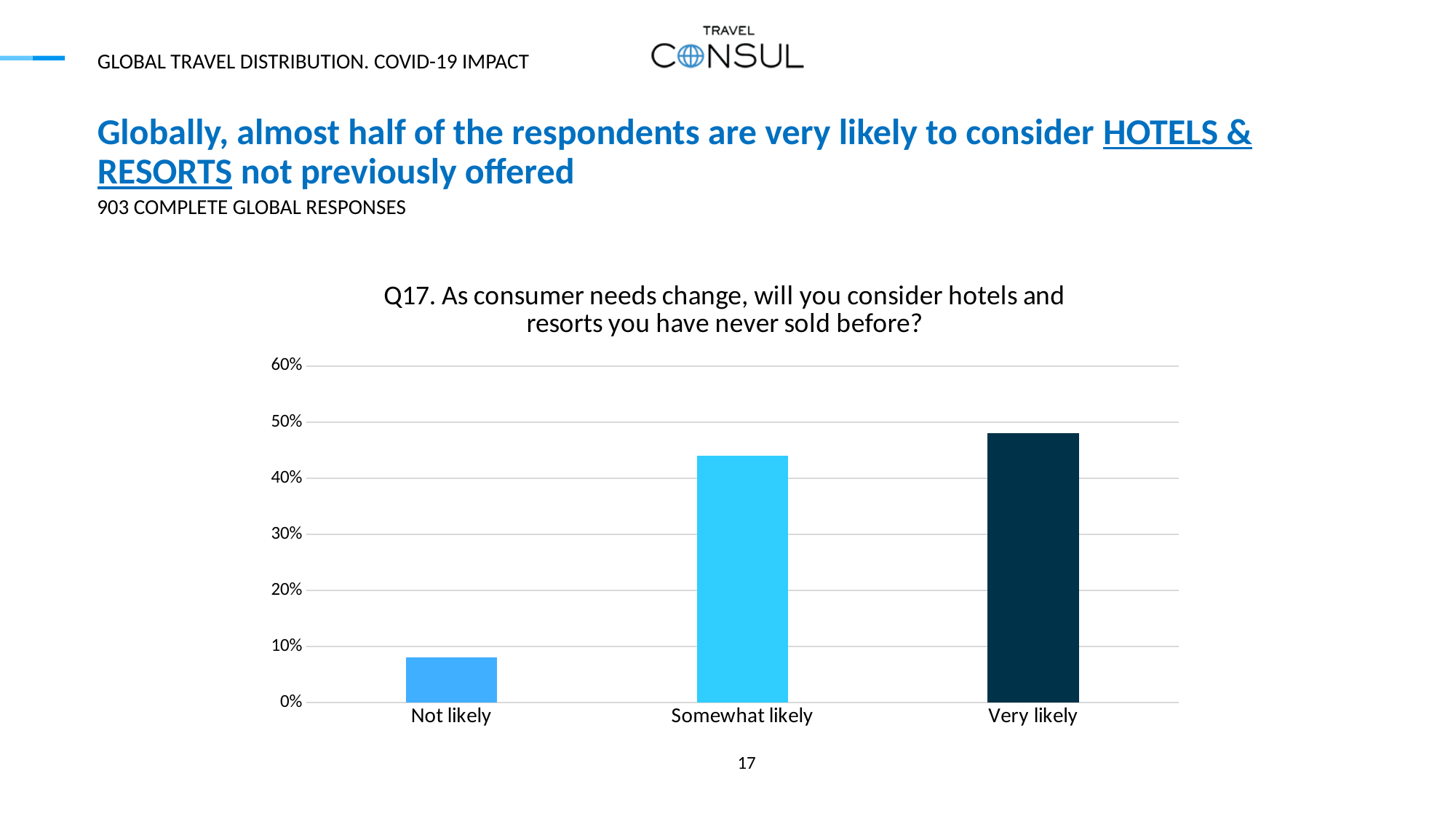
How many categories are shown on the x axis of the chart? 3 Which category has the lowest value in the chart? Not likely Do the values rise or fall moving from left to right along the x axis? rise Is the value for Somewhat likely greater or less than 50%? less What is the highest value shown on the chart's y axis? 60% Is the value for Very likely greater or less than 50%? less Is the value for Not likely greater or less than 10%? less What kind of chart is shown on the slide? bar chart Which is larger, the value for Not likely or the value for Somewhat likely? Somewhat likely What is the title of the chart? Q17. As consumer needs change, will you consider hotels and resorts you have never sold before? Which category has the highest value in the chart? Very likely